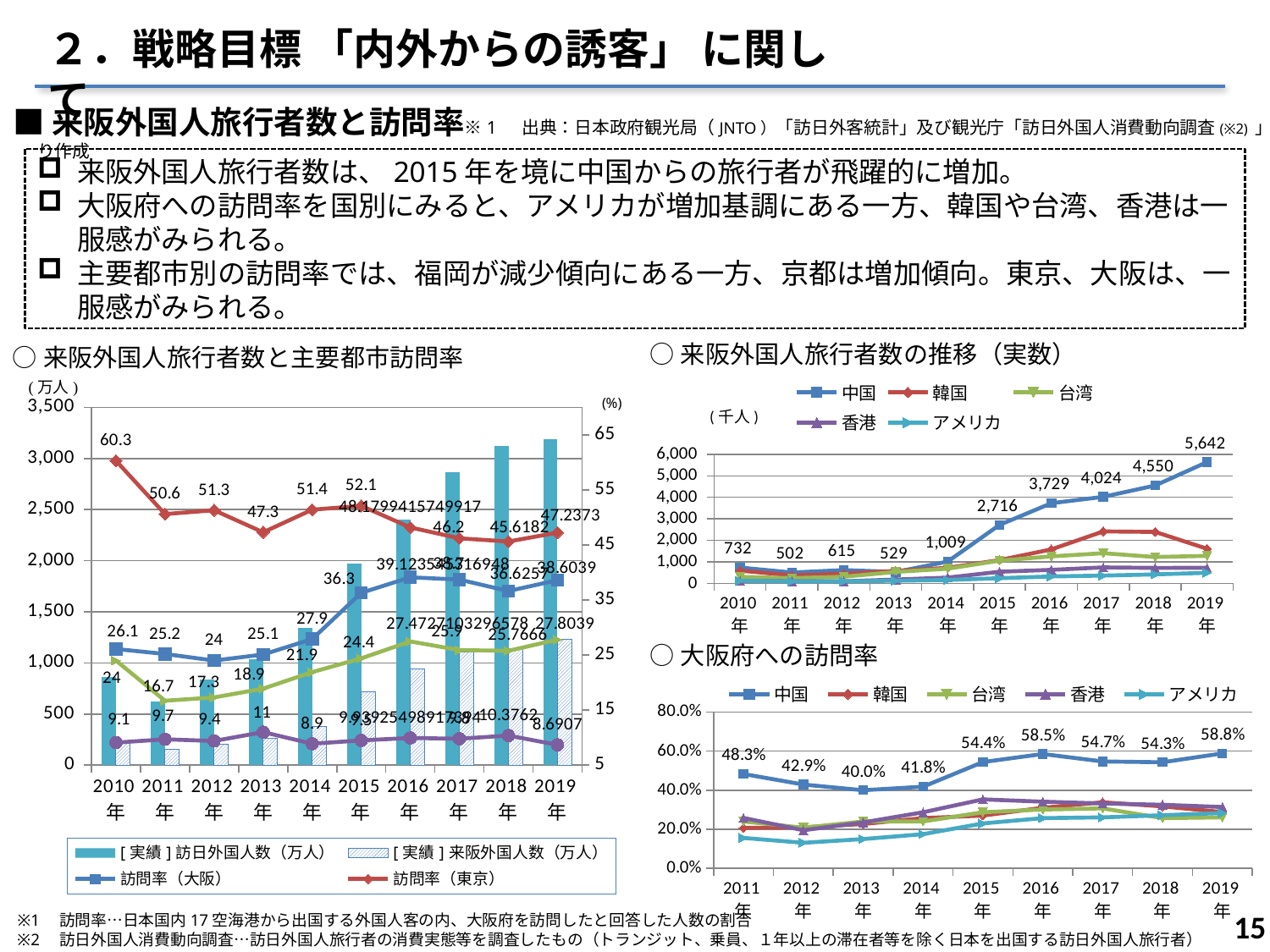
In the chart titled 大阪府への訪問率, in which year is the value for 中国 lowest? 2013年 In the chart titled 来阪外国人旅行者数の推移（実数）, what is the value for 中国 in 2019年? 5,642 In the chart titled 来阪外国人旅行者数と主要都市訪問率, what is the value of 訪問率（東京） in 2010年? 60.3 In the chart titled 来阪外国人旅行者数の推移（実数）, what is the difference between the 中国 values for 2019年 and 2018年? 1,092 What kind of chart is the one titled 大阪府への訪問率? line chart In the chart titled 大阪府への訪問率, is the value for アメリカ in 2012年 greater or less than 20.0%? less In the chart titled 来阪外国人旅行者数の推移（実数）, how many series does the legend list? 5 In the chart titled 来阪外国人旅行者数の推移（実数）, in which year is the value for 中国 highest? 2019年 In the chart titled 来阪外国人旅行者数の推移（実数）, what is the value for 中国 in 2015年? 2,716 In the chart titled 来阪外国人旅行者数と主要都市訪問率, which is larger in 2015年, 訪問率（東京） or 訪問率（大阪）? 訪問率（東京） In the chart titled 大阪府への訪問率, how many years are shown on the x axis? 9 In the chart titled 大阪府への訪問率, what is the value for 中国 in 2016年? 58.5%